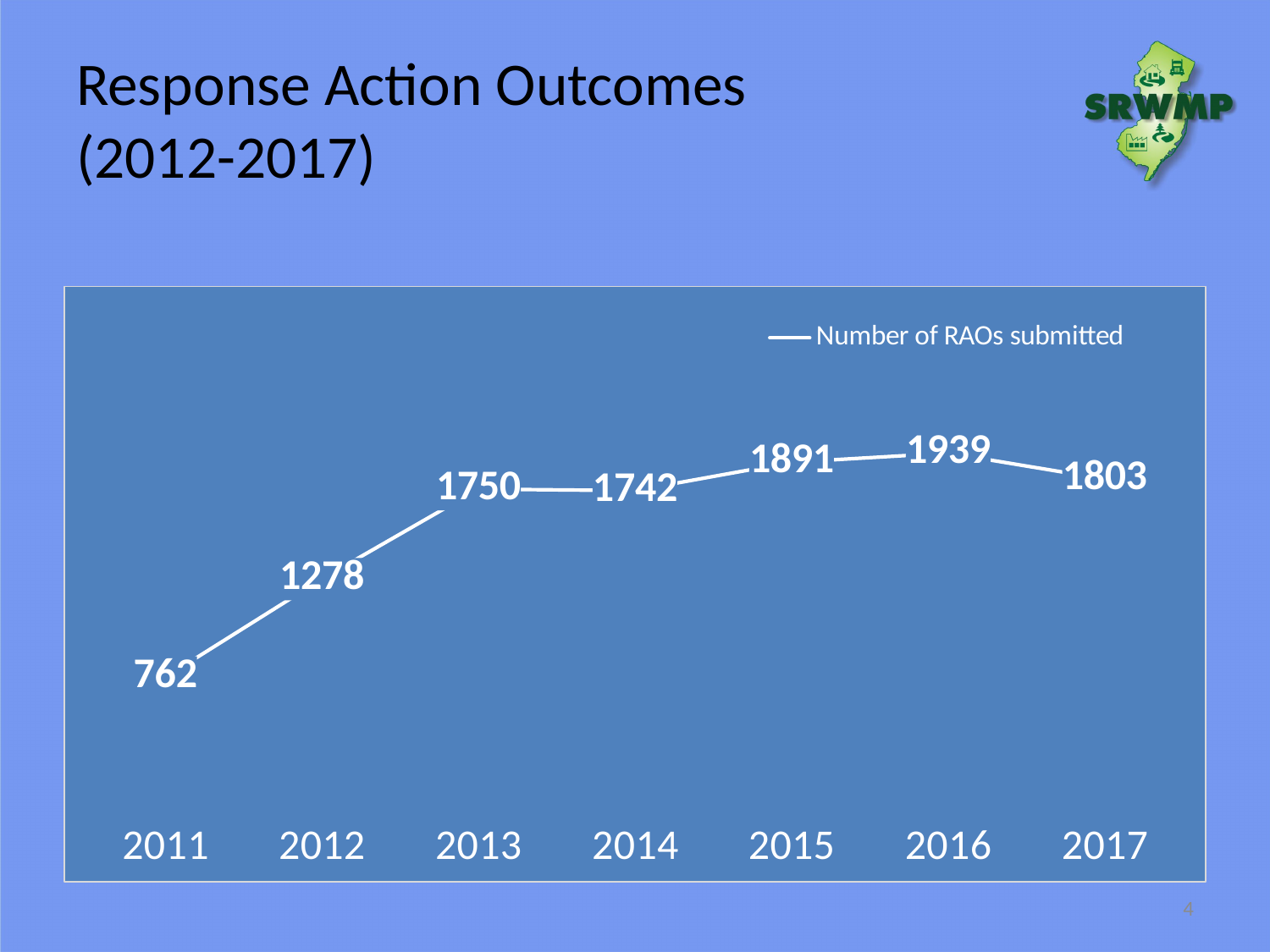
Which year has the lowest number of RAOs submitted? 2011 What is the difference between the number of RAOs submitted in 2012 and in 2011? 516 What is the number of RAOs submitted in 2011? 762 What is the number of RAOs submitted in 2014? 1742 How many years are plotted on the chart? 7 What is the number of RAOs submitted in 2016? 1939 How many series does the legend list? 1 What is the difference between the number of RAOs submitted in 2016 and in 2017? 136 What is the name of the series shown in the legend? Number of RAOs submitted Which year had more RAOs submitted, 2013 or 2014? 2013 Which year has the highest number of RAOs submitted? 2016 What kind of chart is shown on the slide? line chart